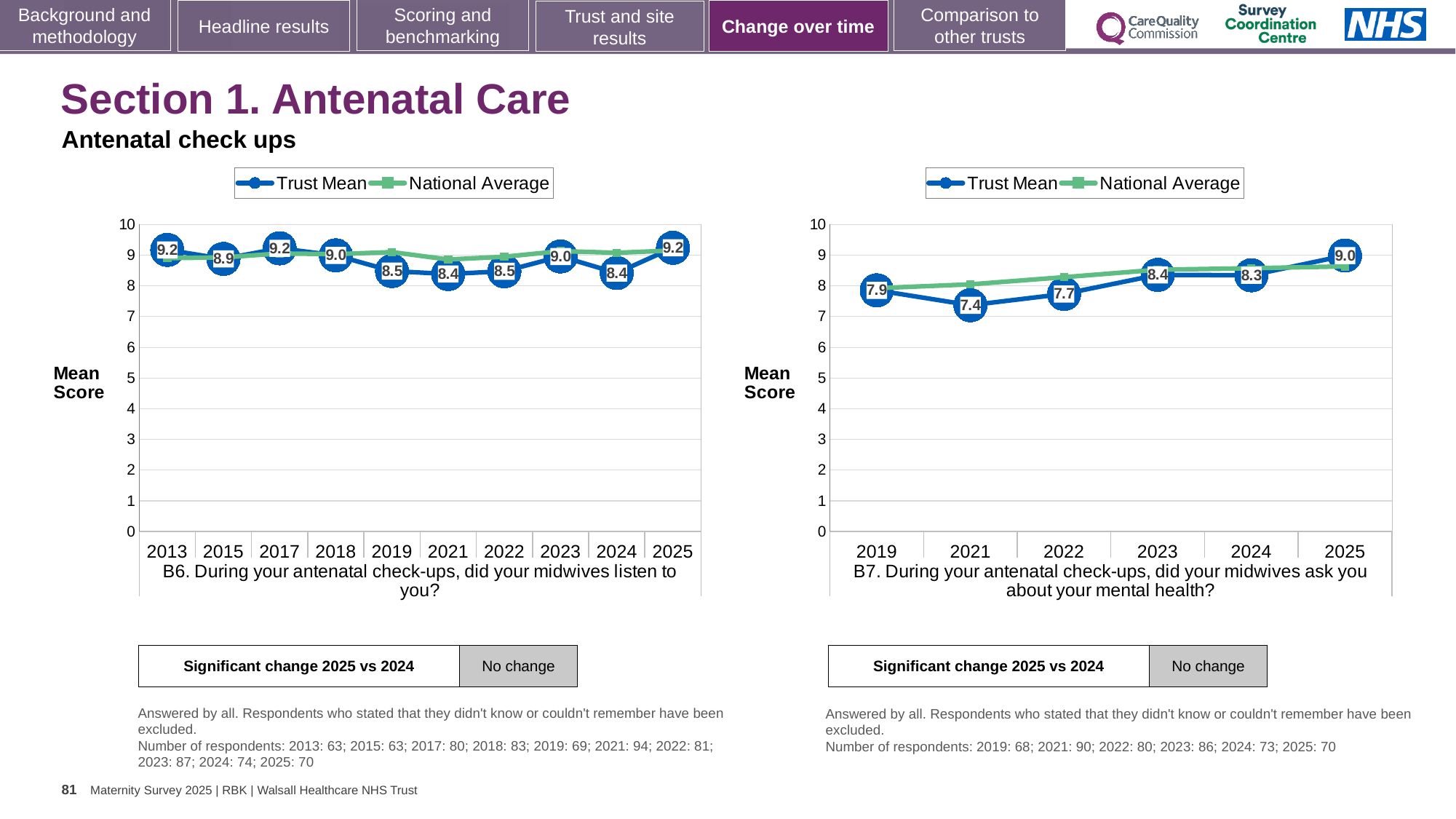
In the B6 chart on the left, is the National Average for 2013 greater or less than 8? greater In the B6 chart on the left, what is the difference between the Trust Mean for 2025 and for 2024? 0.8 In the B6 chart on the left, what is the Trust Mean for 2015? 8.9 How many series does the legend of the B7 chart on the right list? 2 In the B7 chart on the right, what is the difference between the Trust Mean for 2025 and for 2019? 1.1 In the B7 chart on the right, is the Trust Mean higher in 2021 or in 2022? 2022 In the B6 chart on the left, what is the Trust Mean for 2019? 8.5 In the B7 chart on the right, which year has the highest Trust Mean? 2025 In the B7 chart on the right, which year has the lowest Trust Mean? 2021 What type of chart is the B7 chart on the right? Line chart How many years are plotted in the B6 chart on the left? 10 In the B7 chart on the right, what is the Trust Mean for 2022? 7.7